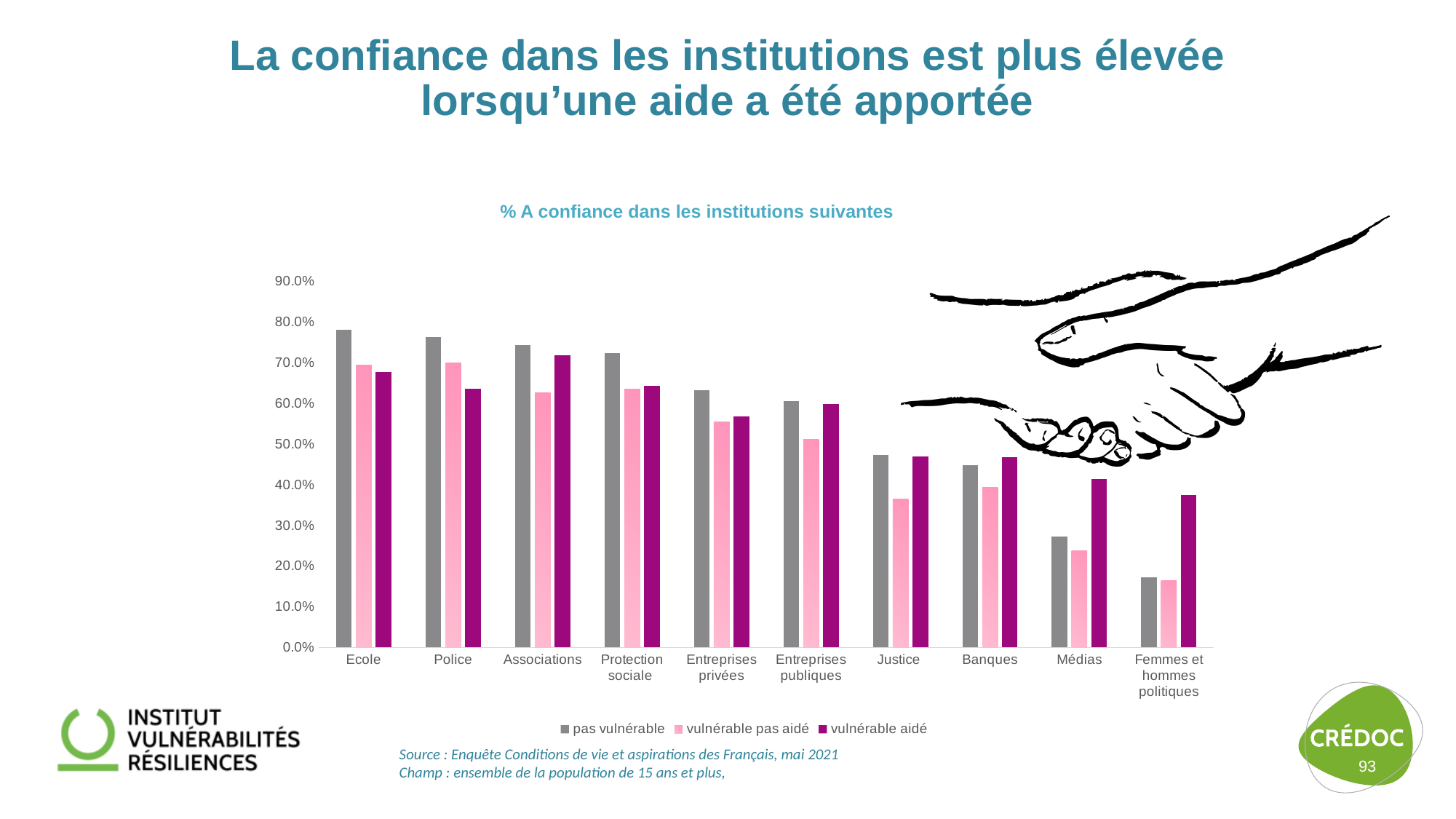
Is the 'vulnérable aidé' value for Médias greater or less than 30.0%? greater For Police, which series has the larger value: 'pas vulnérable' or 'vulnérable aidé'? pas vulnérable What kind of chart is shown on the slide? bar chart How many series does the chart legend list? 3 Do the 'pas vulnérable' values generally rise or fall from left to right across the x axis? fall Is the 'vulnérable pas aidé' value for Justice greater or less than 40.0%? less What is the title of the chart? % A confiance dans les institutions suivantes For Médias, which series has the larger value: 'pas vulnérable' or 'vulnérable aidé'? vulnérable aidé How many institutions (categories) are shown on the x axis of the chart? 10 Is the 'pas vulnérable' value for Ecole greater or less than 70.0%? greater Which institution has the highest value for the 'pas vulnérable' series? Ecole Which institution has the lowest value for the 'vulnérable pas aidé' series? Femmes et hommes politiques